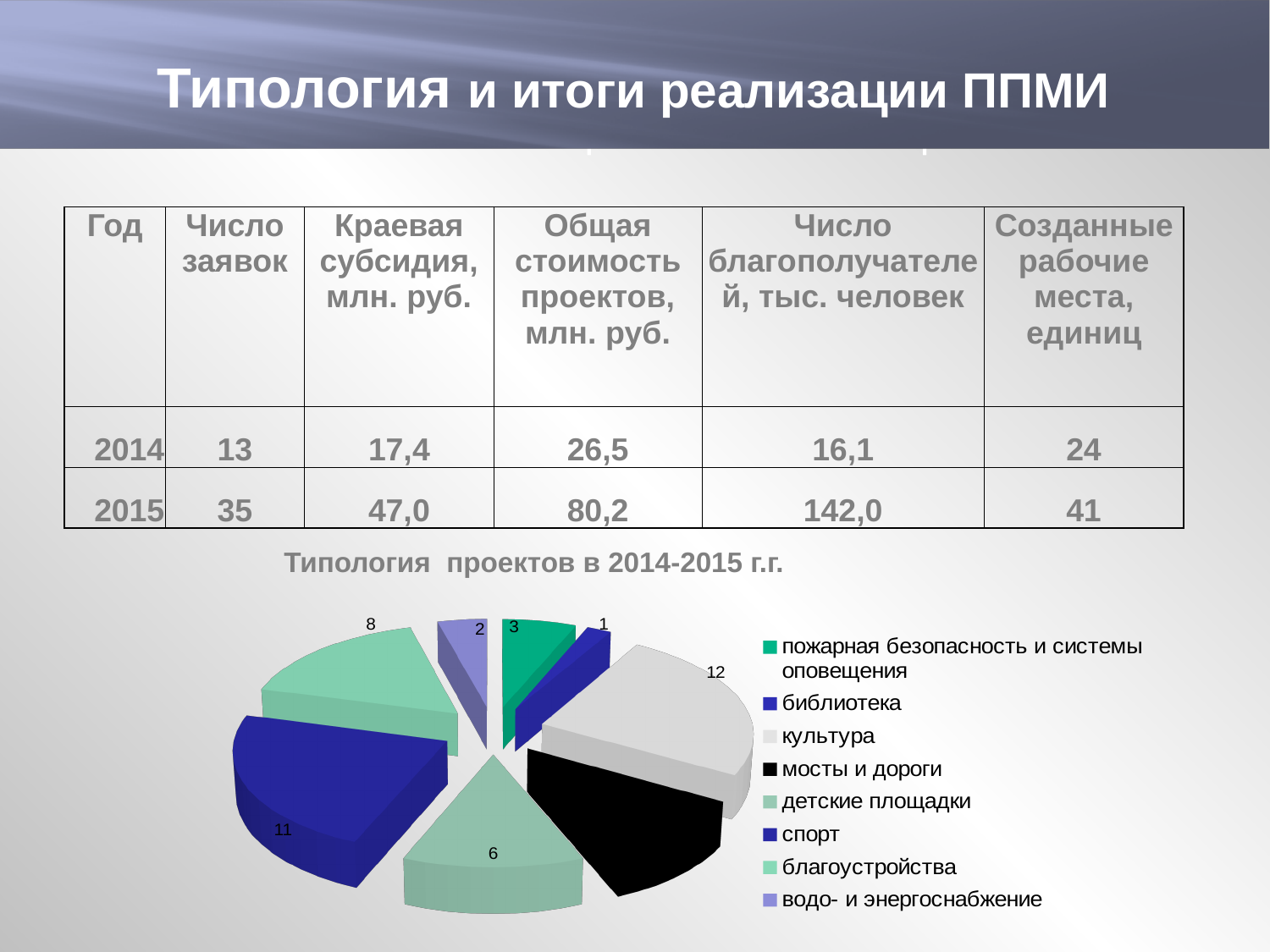
What is the value for спорт in the pie chart? 11 How many categories does the pie chart's legend list? 8 What kind of chart is shown on the slide? pie chart Which is larger in the pie chart: культура or детские площадки? культура Which category has the smallest slice in the pie chart? библиотека What is the value for культура in the pie chart? 12 What is the difference between the values for спорт and благоустройства in the pie chart? 3 What is the value for водо- и энергоснабжение in the pie chart? 2 What is the value for детские площадки in the pie chart? 6 What is the title of the pie chart? Типология проектов в 2014-2015 г.г. What is the value for благоустройства in the pie chart? 8 What is the value for пожарная безопасность и системы оповещения in the pie chart? 3